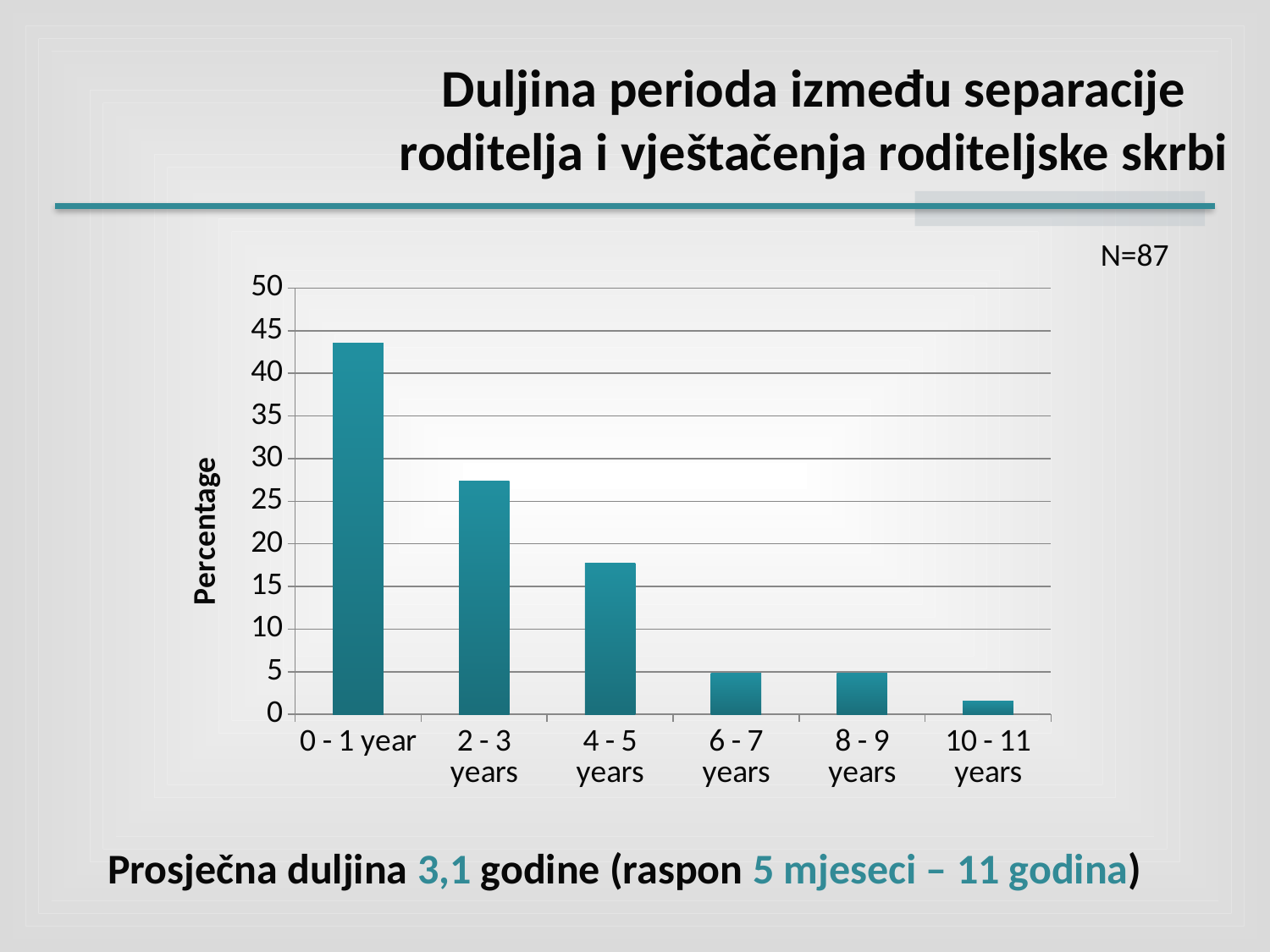
Is the value for 2 - 3 years greater or less than 25? greater Which category has the lowest bar in the chart? 10 - 11 years What kind of chart is shown on the slide? bar chart Is the value for 0 - 1 year greater or less than 40? greater Do the bar values rise or fall as you move from 0 - 1 year to 10 - 11 years along the x axis? fall Is the value for 4 - 5 years greater or less than 20? less Which is larger, the value for 2 - 3 years or the value for 4 - 5 years? 2 - 3 years What is the label of the vertical axis of the chart? Percentage Which category has the highest bar in the chart? 0 - 1 year How many categories are shown on the x axis of the chart? 6 What sample size (N) is stated next to the chart? N=87